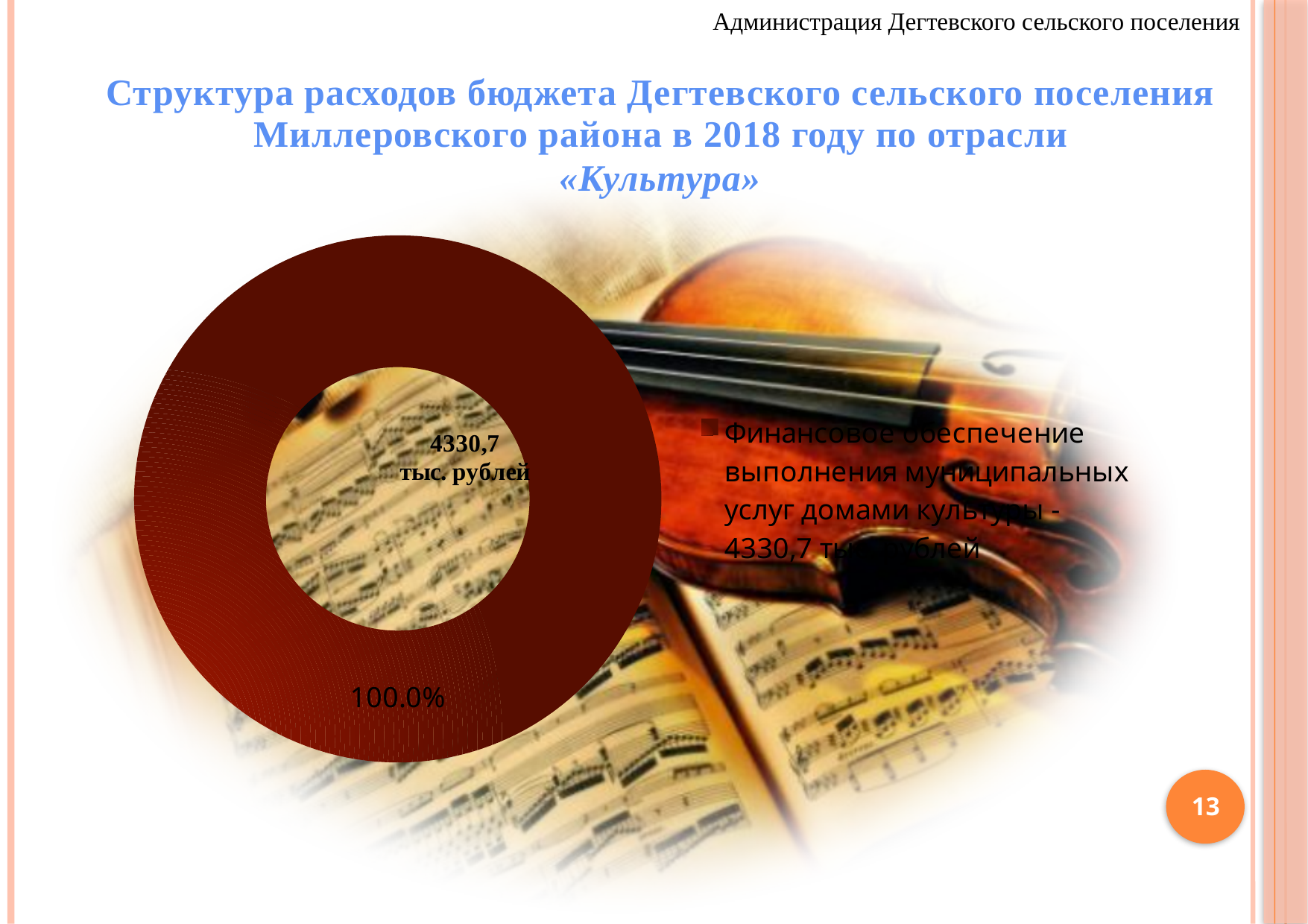
What is the name of the only category shown in the chart's legend? Финансовое обеспечение выполнения муниципальных услуг домами культуры According to the legend, what amount is allocated to «Финансовое обеспечение выполнения муниципальных услуг домами культуры»? 4330,7 тыс. рублей How many entries does the chart's legend list? 1 What kind of chart is shown on the slide? Doughnut (pie) chart How many slices does the doughnut chart have? 1 What share of the doughnut chart does the single slice take? 100.0% Which industry («отрасль») does the chart's title say the budget expenditure structure refers to? «Культура» What value is printed in the centre of the doughnut chart? 4330,7 тыс. рублей